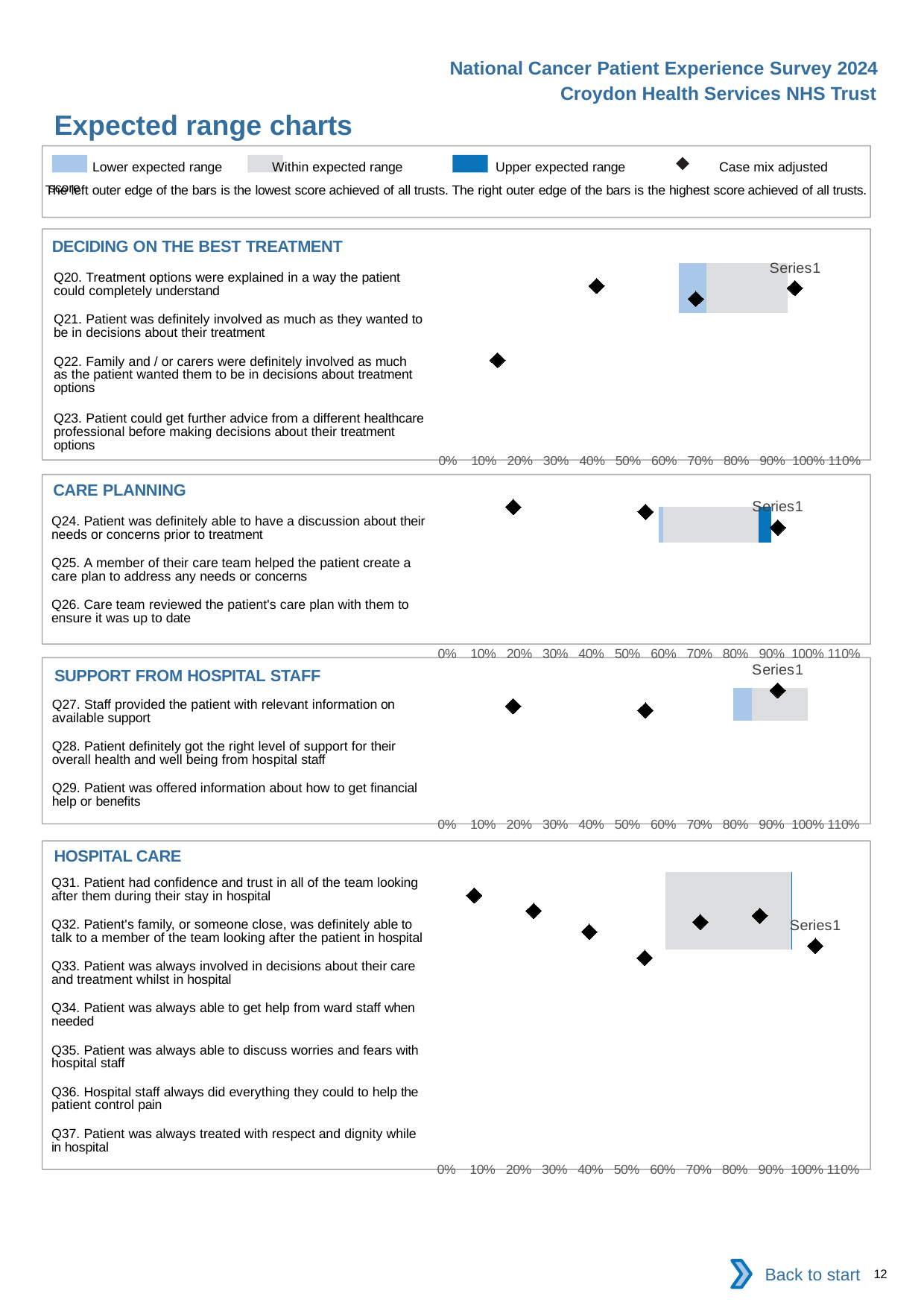
In the "SUPPORT FROM HOSPITAL STAFF" chart, how many questions (categories) are listed? 3 In the "CARE PLANNING" chart, how many questions (categories) are listed? 3 In the "HOSPITAL CARE" chart, how many questions (categories) are listed? 7 What kind of chart is the "DECIDING ON THE BEST TREATMENT" chart? bar chart What is the title of the chart that lists questions Q31 to Q37? HOSPITAL CARE In the "CARE PLANNING" chart, which question number is listed first? Q24 In the "SUPPORT FROM HOSPITAL STAFF" chart, which question number is listed last? Q29 According to the legend at the top of the slide, what does the diamond marker represent? Case mix adjusted score